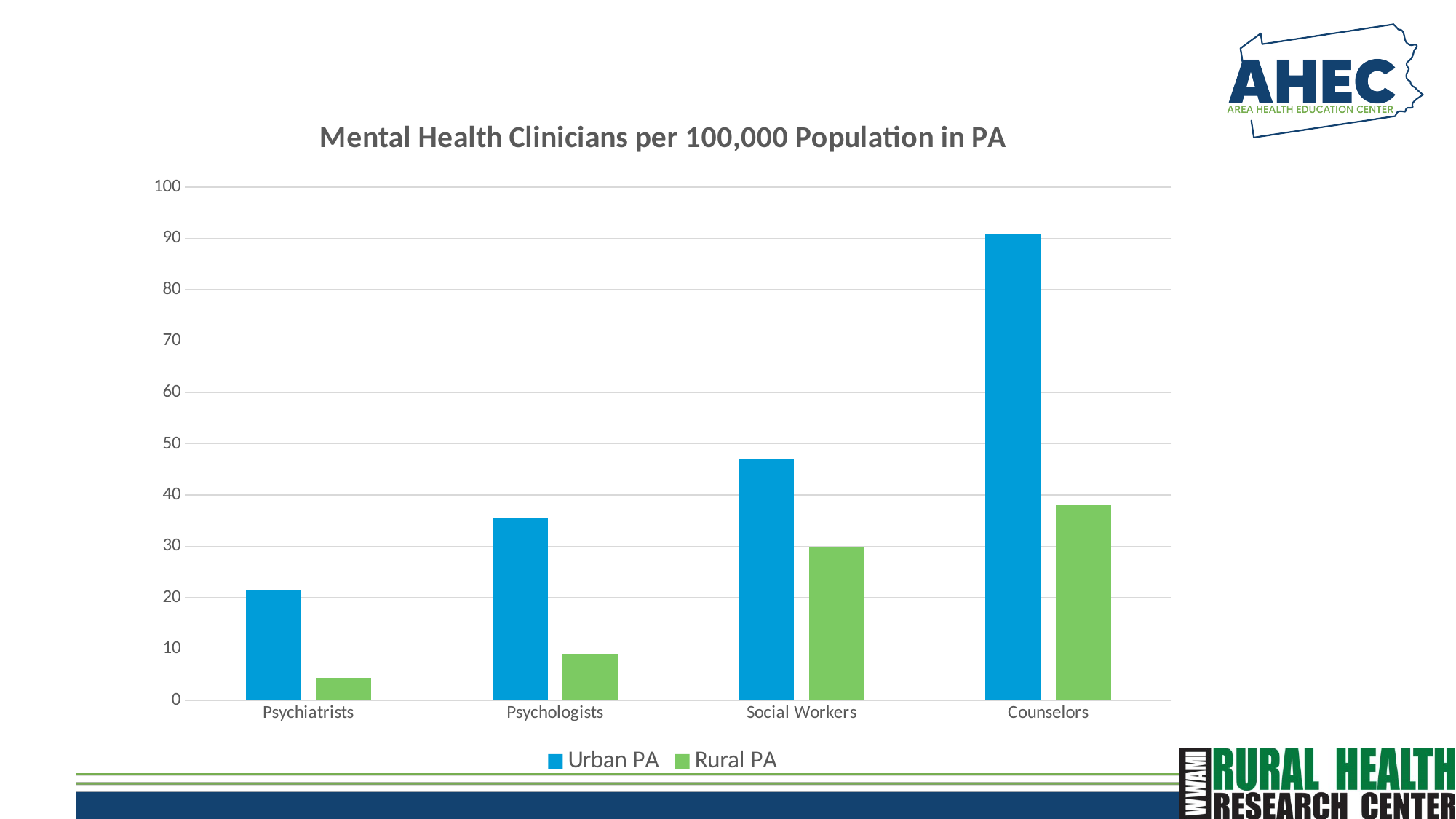
Which category has the highest Urban PA value? Counselors What is the title of the chart? Mental Health Clinicians per 100,000 Population in PA Which is larger for Social Workers, the Urban PA value or the Rural PA value? Urban PA Is the Urban PA value for Social Workers greater or less than 40? greater How many series does the legend list? 2 What type of chart is shown on the slide? bar chart Which category has the lowest Rural PA value? Psychiatrists Is the Rural PA value for Psychiatrists greater or less than 10? less Is the Rural PA value for Psychologists greater or less than 20? less How many clinician categories are shown on the x axis? 4 Do the Urban PA values rise or fall moving from Psychiatrists to Counselors along the x axis? rise